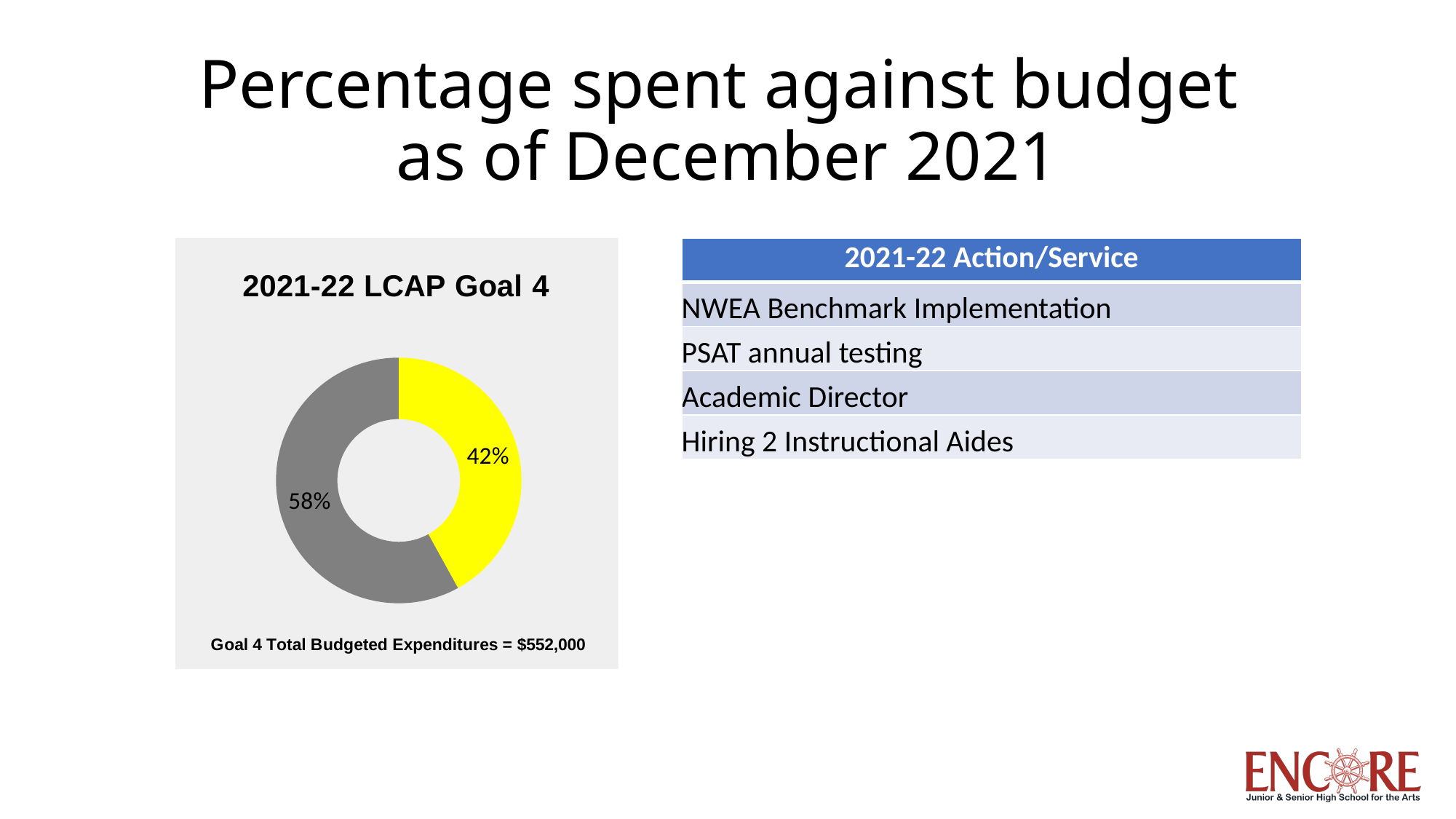
What kind of chart is shown on the slide? doughnut chart What is the title of the chart? 2021-22 LCAP Goal 4 Which colour slice represents the largest share of the doughnut chart? gray Is the share of the yellow slice greater or less than 50%? less Which slice of the doughnut chart is larger, the yellow one or the gray one? the gray one How many slices does the doughnut chart have? 2 What percentage is shown on the yellow slice of the doughnut chart? 42% What percentage is shown on the gray slice of the doughnut chart? 58% What total budgeted expenditure for Goal 4 is stated below the chart? $552,000 Which colour slice represents the smallest share of the doughnut chart? yellow By how many percentage points does the gray slice exceed the yellow slice? 16